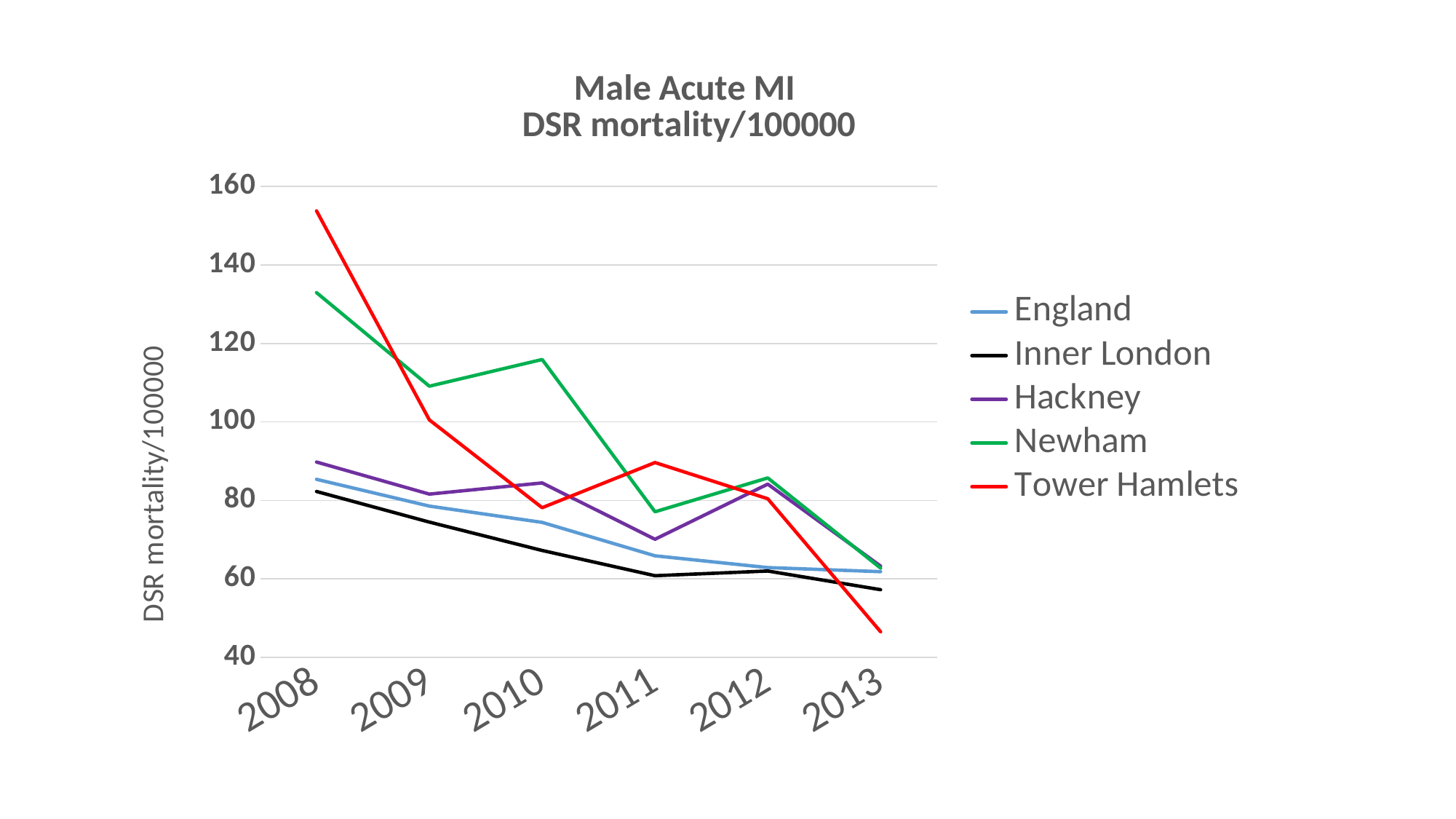
Is the value for Newham in 2010 greater or less than 100? greater Does the England series rise or fall from 2008 to 2013? fall Which series has the lowest value in 2013? Tower Hamlets How many series does the legend list? 5 How many years are shown on the x axis? 6 What kind of chart is shown on the slide? line chart Which series has the highest value in 2008? Tower Hamlets In 2011, which is larger: the value for Tower Hamlets or the value for Newham? Tower Hamlets Is the value for Tower Hamlets in 2008 greater or less than 140? greater Which series has the highest value in 2010? Newham Is the value for Tower Hamlets in 2013 greater or less than 60? less What colour is the line for Newham? green